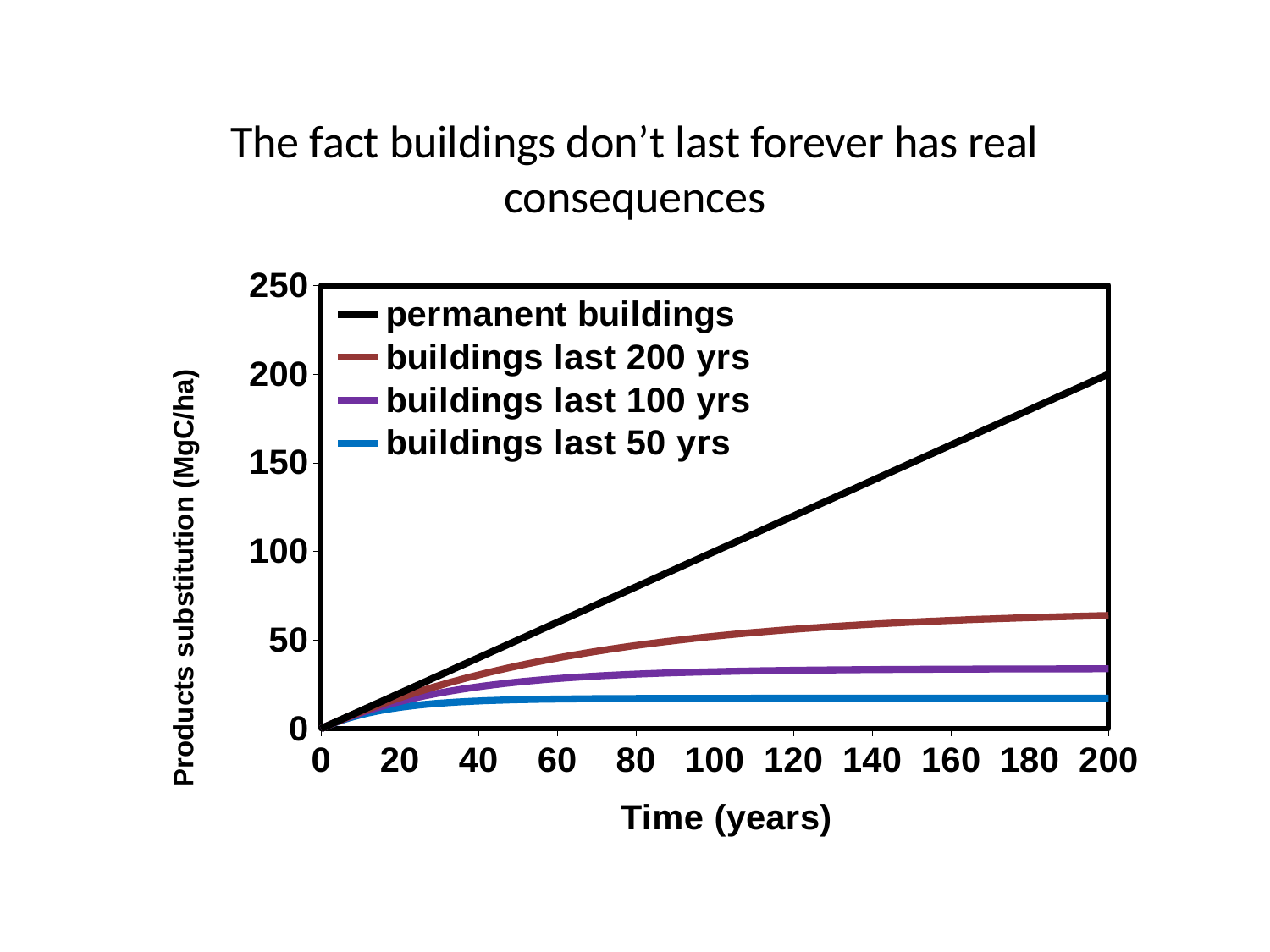
At 200 years, which is larger: buildings last 200 yrs or buildings last 100 yrs? buildings last 200 yrs Is the value for buildings last 100 yrs at 200 years greater or less than 50? less How many series does the legend list? 4 What is the value for permanent buildings at 200 years? 200 Which series has the lowest value at 200 years? buildings last 50 yrs Is the value for buildings last 200 yrs at 200 years greater or less than 50? greater What is the label of the y axis? Products substitution (MgC/ha) Which series has the highest value at 200 years? permanent buildings Is the value for buildings last 50 yrs at 200 years greater or less than 50? less Does the permanent buildings line rise or fall as time increases? rise What colour is the line for permanent buildings? black What kind of chart is shown on the slide? line chart